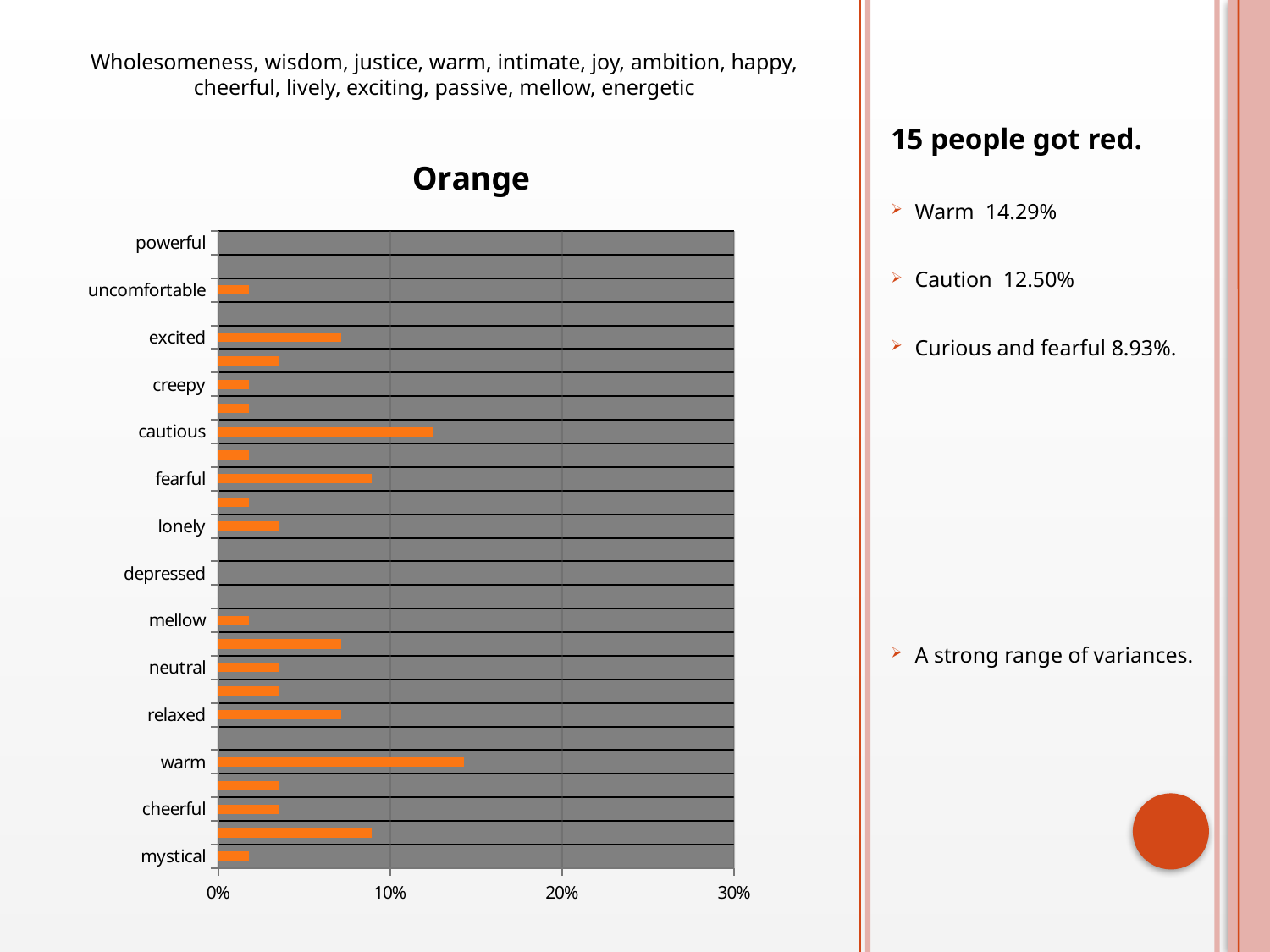
Which labeled category has the longest bar in the chart? warm Is the value for cautious greater or less than 10%? greater Is the value for fearful greater or less than 10%? less What kind of chart is shown on the slide? bar chart Which has the larger value, warm or cautious? warm Is the value for warm greater or less than 10%? greater What is the title of the chart? Orange What is the highest value shown on the horizontal axis of the chart? 30% How many category labels are shown on the vertical axis of the chart? 14 Which has the larger value, excited or fearful? fearful Which has the larger value, uncomfortable or lonely? lonely